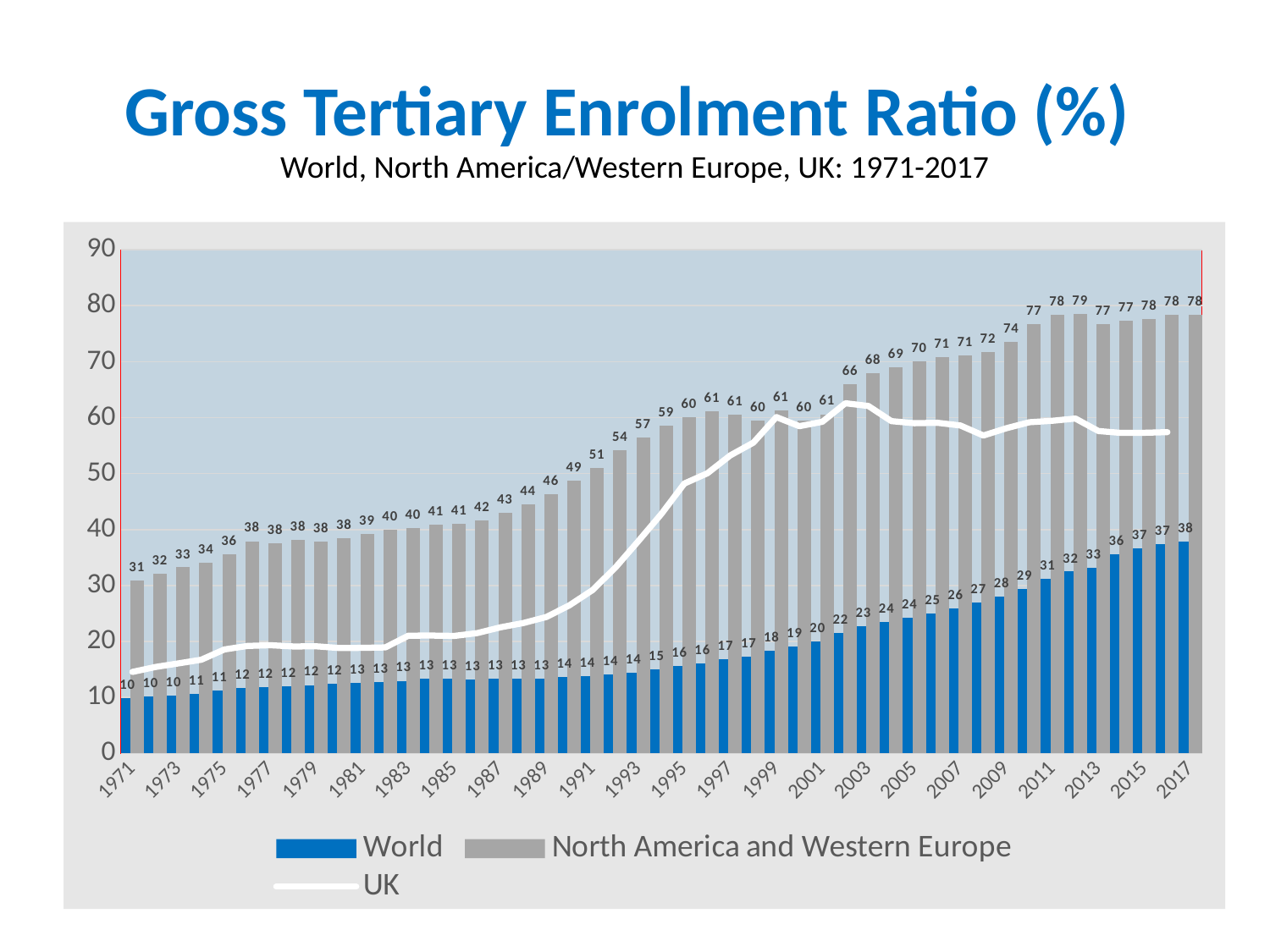
In which year does the North America and Western Europe series reach its highest value? 2012 How many series does the legend list? 3 Does the World series rise or fall from 1971 to 2017? rise What is the North America and Western Europe value in 2017? 78 Which is larger in 2017, the World value or the North America and Western Europe value? North America and Western Europe What is the North America and Western Europe value in 1971? 31 Is the UK value in 1971 greater or less than 20? less What is the difference between the North America and Western Europe value and the World value in 2017? 40 What is the World gross tertiary enrolment ratio in 2017? 38 What is the World value in 1971? 10 What is the highest value shown for North America and Western Europe? 79